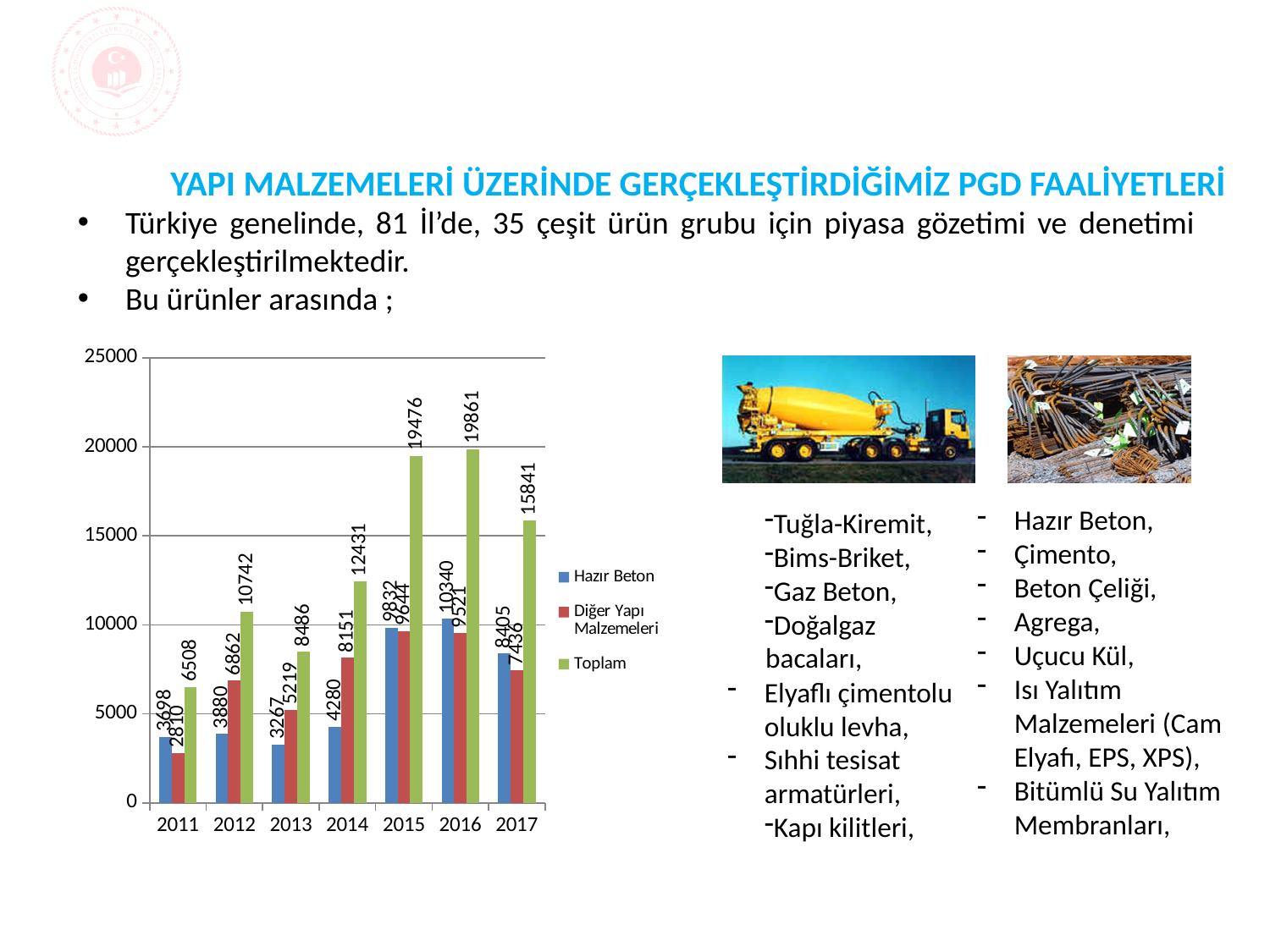
What is the Diğer Yapı Malzemeleri value for 2013? 5219 Is the Toplam value for 2017 greater or less than 15000? greater In 2014, which is larger: Hazır Beton or Diğer Yapı Malzemeleri? Diğer Yapı Malzemeleri How many years are shown on the x axis of the chart? 7 What is the Toplam value for 2014? 12431 Does the Toplam value rise or fall from 2016 to 2017? fall What kind of chart is shown on the slide? bar chart What is the Hazır Beton value for 2012? 3880 How many series does the chart's legend list? 3 In which year is the Toplam value highest? 2016 What is the difference between the Toplam values for 2016 and 2015? 385 In which year is the Toplam value lowest? 2011